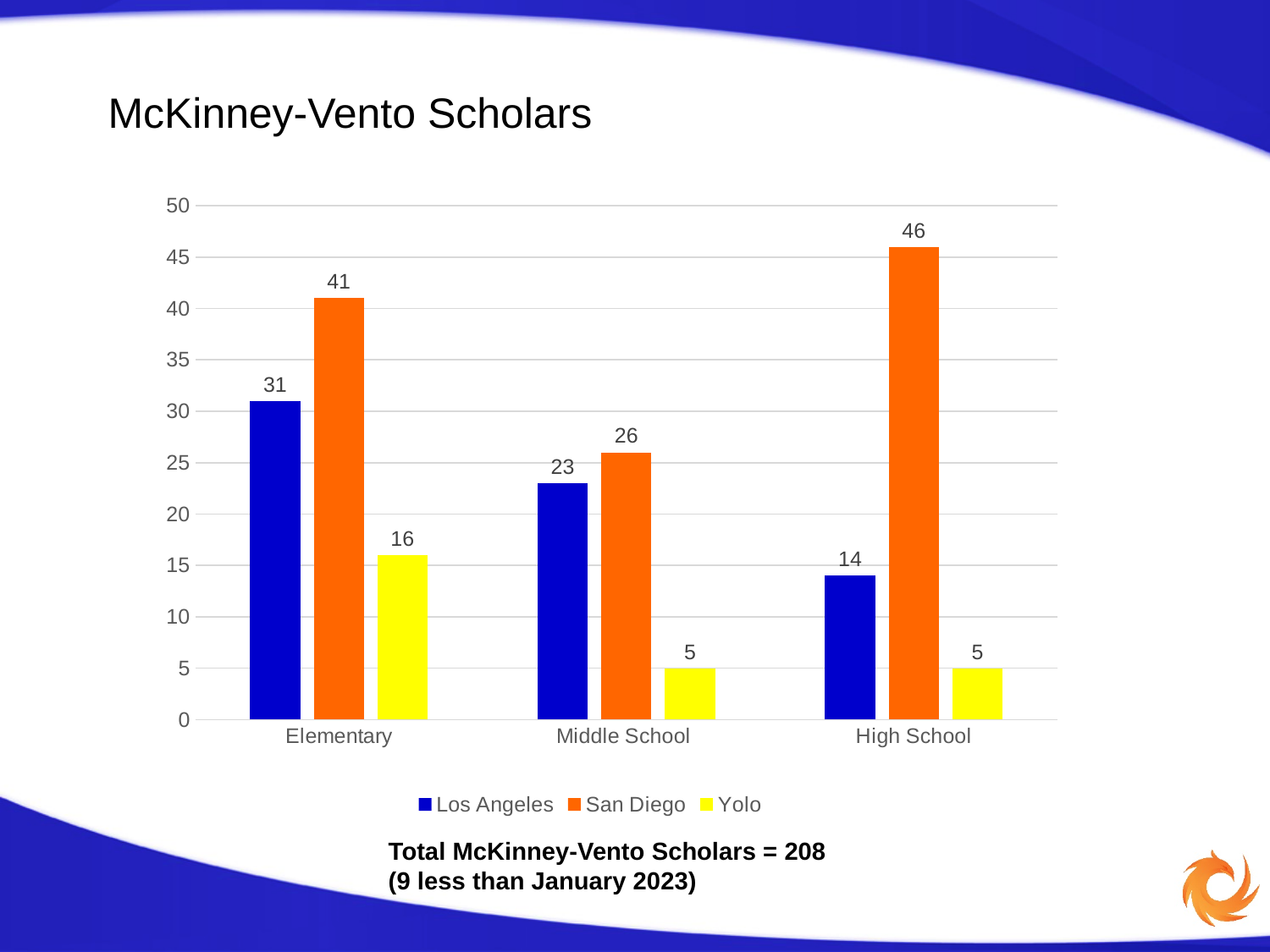
How many categories are shown on the x axis? 3 How many series does the legend list? 3 What is the value for San Diego in the Elementary category? 41 Which category has the highest San Diego value? High School Do the Yolo values rise or fall from Elementary to High School? Fall What is the title of the chart? McKinney-Vento Scholars What is the difference between the San Diego and Los Angeles values for High School? 32 What kind of chart is shown on the slide? Bar chart Which is larger, the Los Angeles value for Elementary or the San Diego value for Middle School? Los Angeles value for Elementary Which category has the lowest Los Angeles value? High School What is the value for Yolo in the High School category? 5 What is the value for Los Angeles in the Middle School category? 23